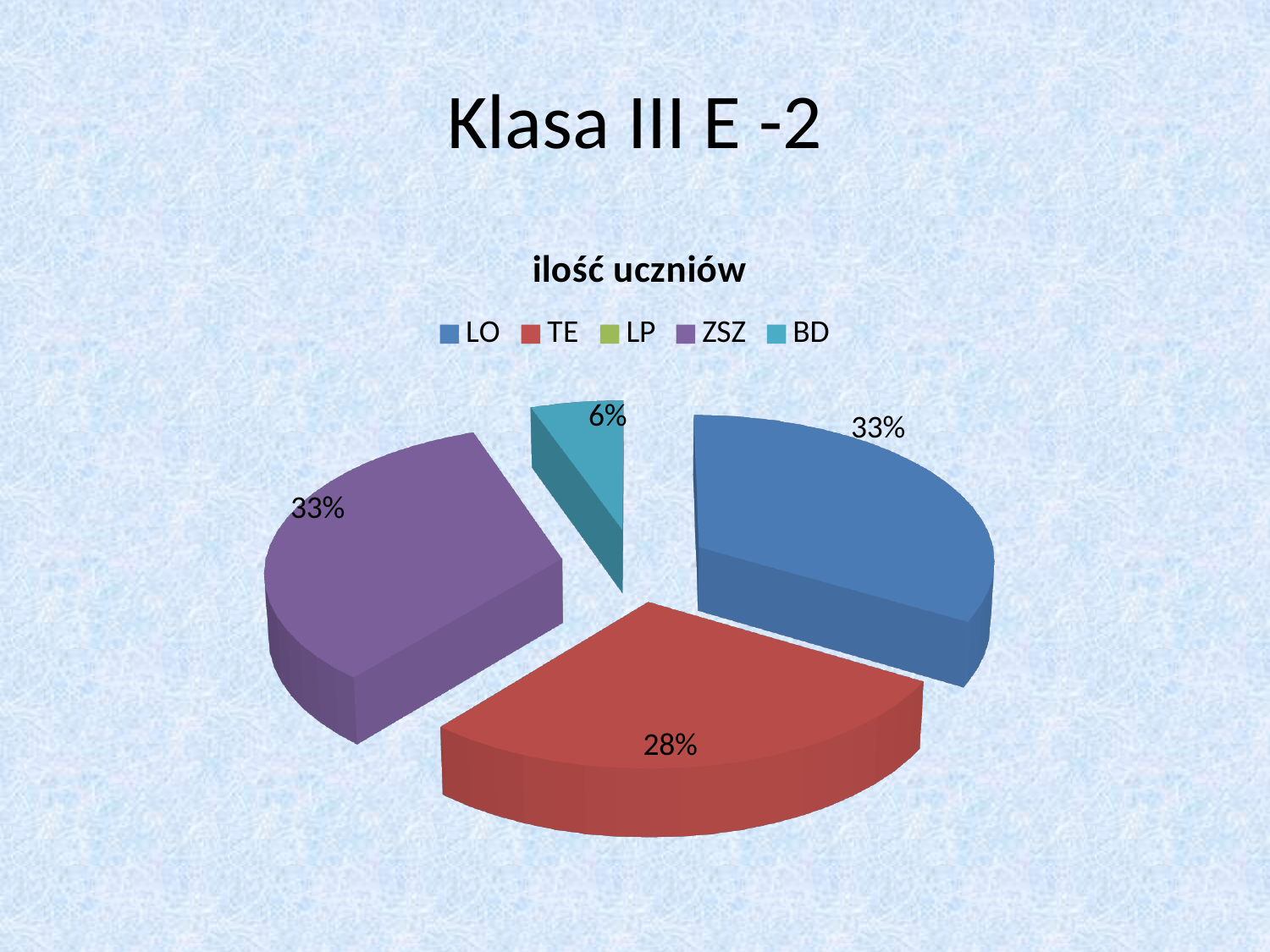
What is the difference in percentage points between the LO share and the TE share? 5% What share of the pie does ZSZ have? 33% What share of the pie does BD have? 6% What colour is the slice for TE? red Which category has the smallest visible slice of the pie? BD What share of the pie does LO have? 33% What kind of chart is shown on the slide? pie chart Which legend entry has no visible slice in the pie? LP What is the title of the chart? ilość uczniów What share of the pie does TE have? 28% Which is larger, the share for TE or the share for BD? TE How many entries does the chart legend list? 5